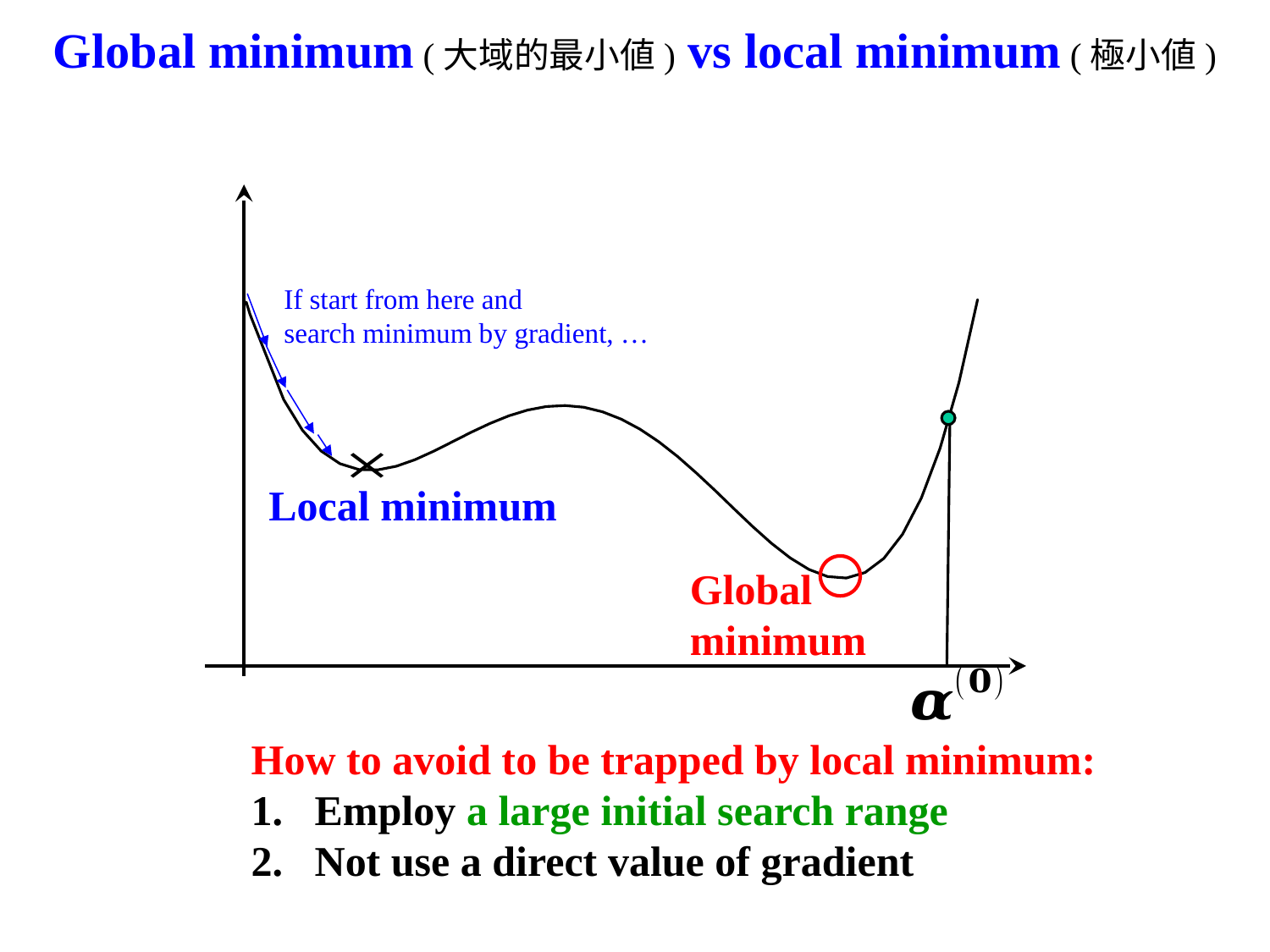
Which labeled minimum is closer to the vertical axis, the local minimum or the global minimum? Local minimum What symbol marks the global minimum on the curve? A red circle What kind of chart is shown on the slide? Line chart Which labeled point on the curve is lower, the local minimum or the global minimum? Global minimum Does the curve rise or fall immediately to the right of the global minimum? Rises How many minima are labeled on the curve? 2 What label is written on the x axis below the green dot? α^(0) Does the curve rise or fall from the starting point of the blue arrows down to the local minimum? Falls